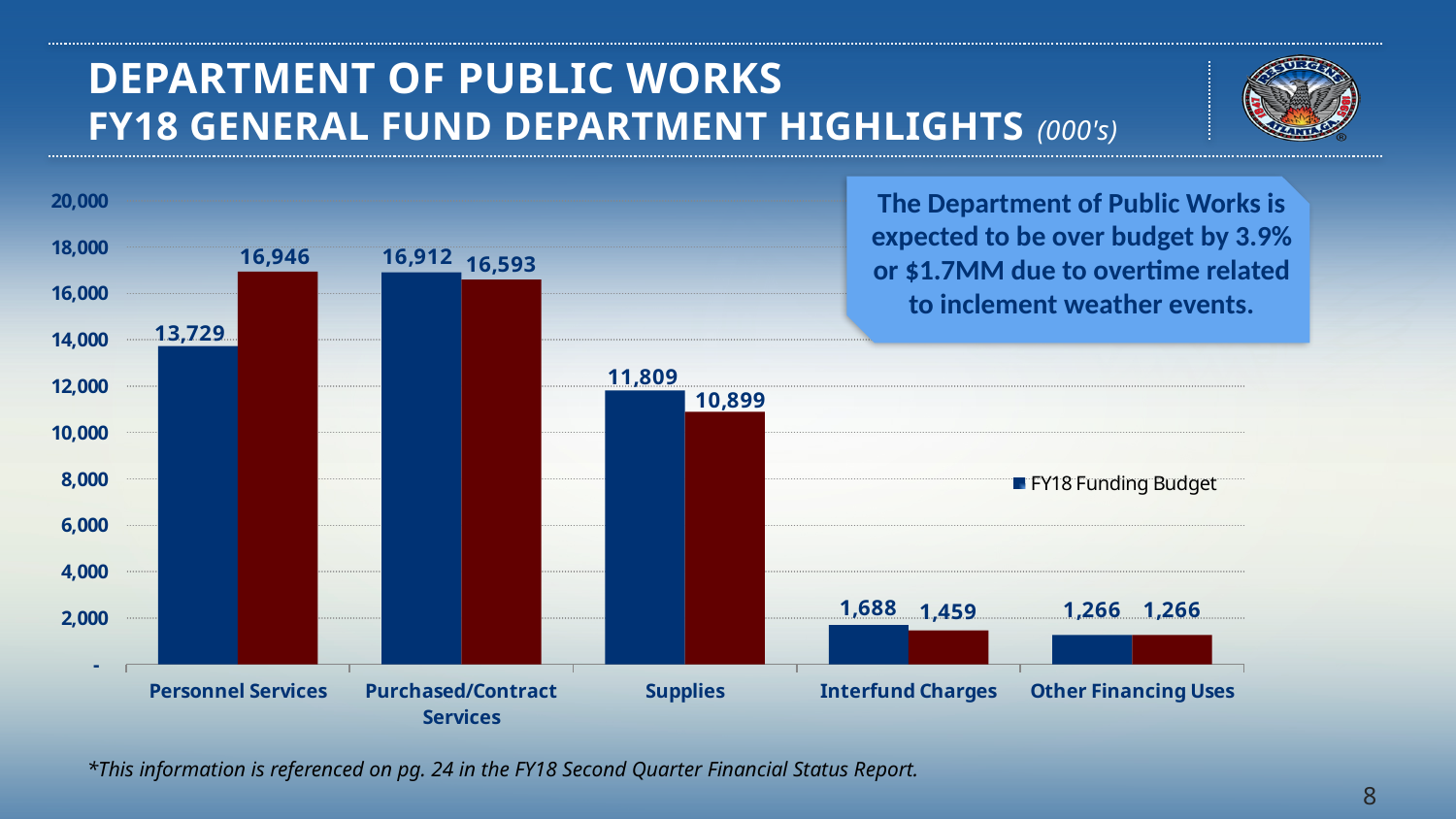
For Personnel Services, what is the difference between the dark red bar (16,946) and the FY18 Funding Budget bar (13,729)? 3,217 What is the value of the dark red bar for Supplies? 10,899 For Supplies, how much larger is the FY18 Funding Budget value than the dark red bar value? 910 What is the FY18 Funding Budget value for Personnel Services? 13,729 What is the FY18 Funding Budget value for Other Financing Uses? 1,266 Which category has the lowest FY18 Funding Budget value? Other Financing Uses What type of chart is shown on the slide? Bar chart Is the FY18 Funding Budget value for Interfund Charges greater or less than 2,000? less For Personnel Services, which is larger: the FY18 Funding Budget bar or the dark red bar? The dark red bar Which category has the highest FY18 Funding Budget value? Purchased/Contract Services How many categories are shown on the x axis of the chart? 5 For Interfund Charges, what is the difference between the FY18 Funding Budget value and the dark red bar value? 229